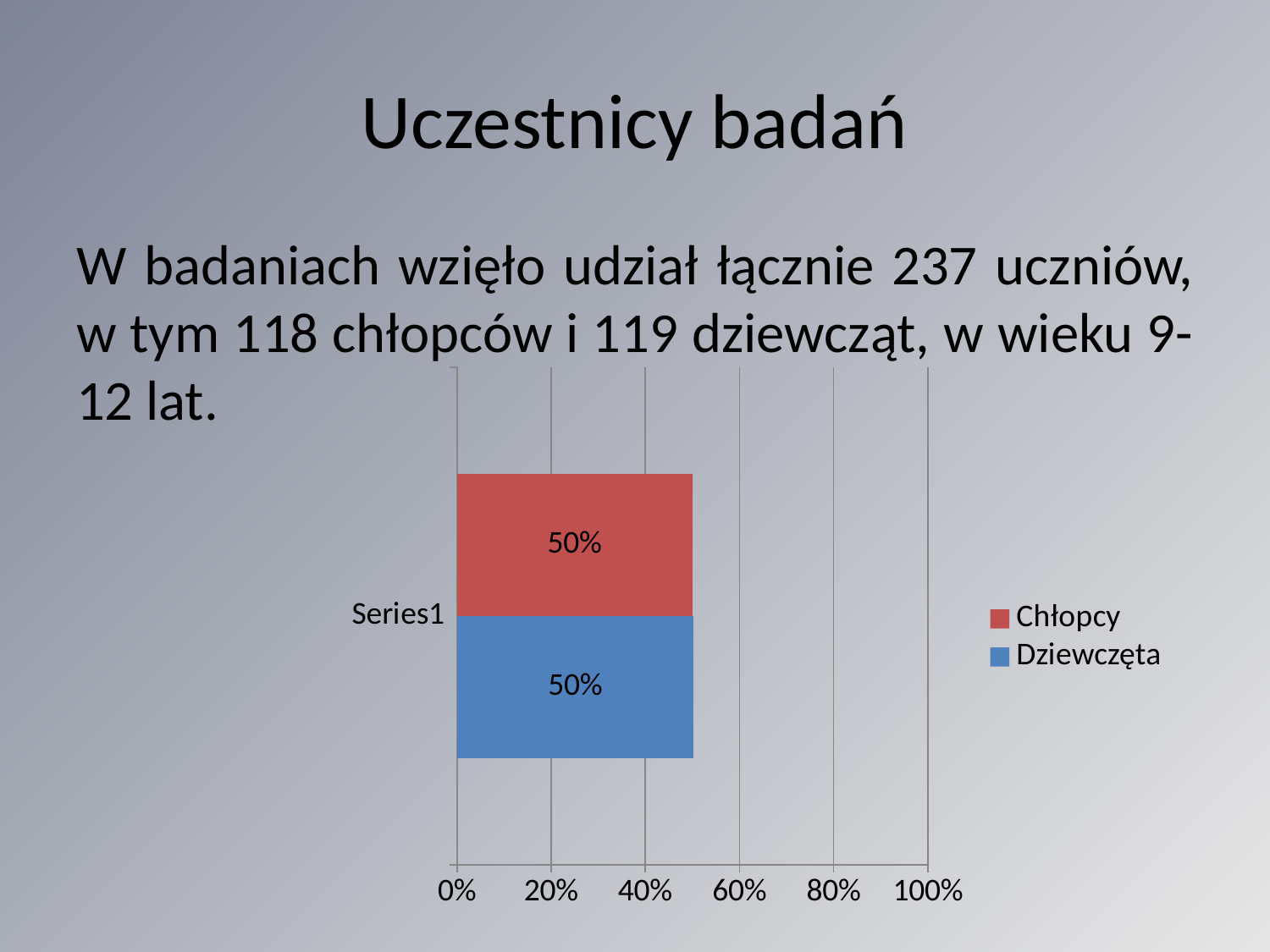
What kind of chart is shown on the slide? Bar chart How many categories are shown on the vertical axis of the chart? 1 Which colour represents Chłopcy in the legend? Red How many series does the legend list? 2 What is the label of the category on the vertical axis? Series1 What is the value for Chłopcy? 50% What is the value for Dziewczęta? 50% Is the value for Dziewczęta greater or less than 40%? greater Is the value for Chłopcy greater or less than 60%? less What is the difference between the values for Chłopcy and Dziewczęta? 0%